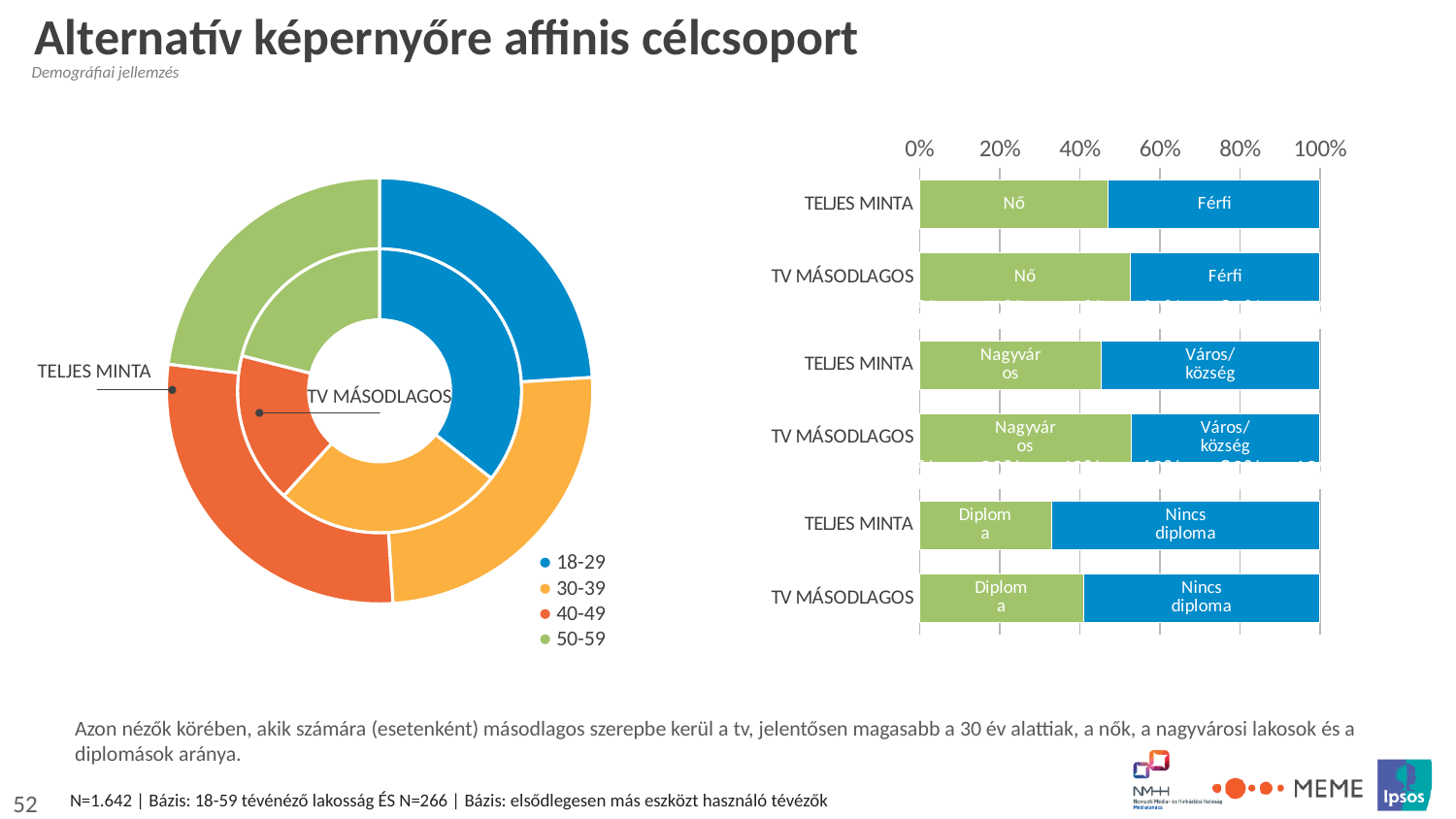
What kind of chart is the chart on the left of the slide? doughnut chart In the doughnut chart, which ring represents TV MÁSODLAGOS, the inner or the outer ring? inner ring What kind of chart is the chart on the right of the slide? stacked bar chart In the stacked bar chart, is the Diploma share for TELJES MINTA greater or less than 40%? less In the stacked bar chart, is the Nő share for TV MÁSODLAGOS greater or less than 60%? less In the stacked bar chart, what is the highest value shown on the percentage axis? 100% In the stacked bar chart, is the Nő share for TV MÁSODLAGOS greater or less than 40%? greater How many bars does the stacked bar chart on the right contain? 6 In the stacked bar chart, which is larger for TELJES MINTA: Diploma or Nincs diploma? Nincs diploma How many age groups does the legend of the doughnut chart list? 4